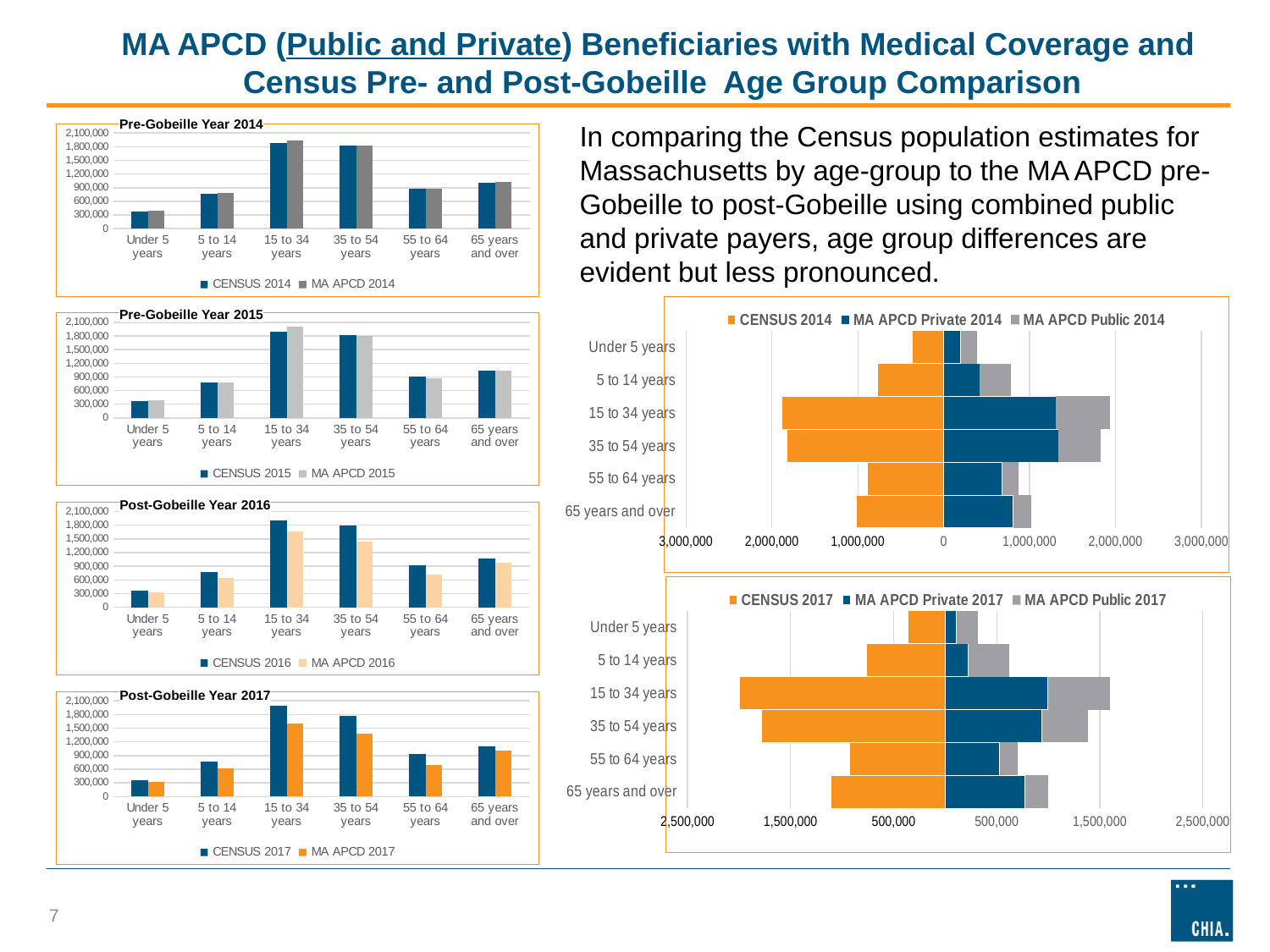
In the right-hand 2014 chart, what colour represents the CENSUS 2014 series? orange How many age groups are shown on the x axis of the Pre-Gobeille Year 2015 chart? 6 In the Post-Gobeille Year 2017 chart, is the value for CENSUS 2017 in the 15 to 34 years group greater or less than 1,800,000? greater How many series does the legend of the Post-Gobeille Year 2016 chart list? 2 In the Pre-Gobeille Year 2014 chart, which age group has the highest value for MA APCD 2014? 15 to 34 years In the Pre-Gobeille Year 2014 chart, which age group has the lowest value for CENSUS 2014? Under 5 years What kind of chart is the Post-Gobeille Year 2017 chart? bar chart In the right-hand 2017 chart (CENSUS 2017, MA APCD Private 2017, MA APCD Public 2017), which age group has the highest CENSUS 2017 value? 15 to 34 years How many series does the legend of the right-hand chart with CENSUS 2014, MA APCD Private 2014 and MA APCD Public 2014 list? 3 In the Post-Gobeille Year 2017 chart, is the value for MA APCD 2017 in the 15 to 34 years group greater or less than 1,800,000? less In the Post-Gobeille Year 2016 chart, is the value for MA APCD 2016 in the 55 to 64 years group greater or less than 900,000? less In the Post-Gobeille Year 2017 chart, which is larger for the 35 to 54 years group: CENSUS 2017 or MA APCD 2017? CENSUS 2017